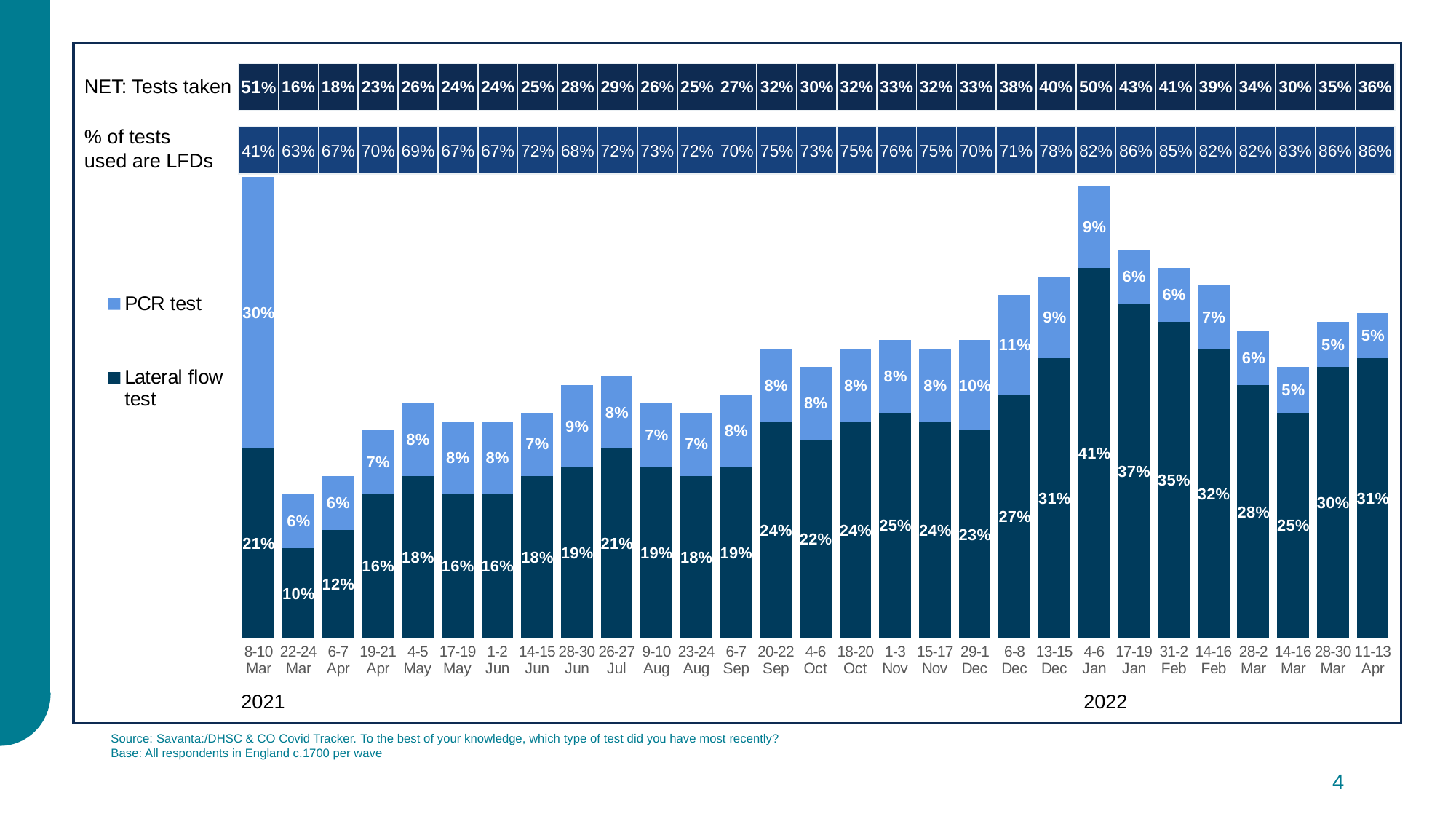
What is the NET: Tests taken value for 13-15 Dec 2021? 40% What is the total of the stacked bar for 11-13 Apr 2022? 36% Which wave has the lowest Lateral flow test value? 22-24 Mar 2021 Which wave has the highest Lateral flow test value? 4-6 Jan 2022 Which is larger, the PCR test value for 6-8 Dec 2021 or for 29-1 Dec 2021? 6-8 Dec 2021 How many date waves (bars) are plotted on the chart? 29 What kind of chart is shown on the slide? Stacked bar chart What is the difference between the Lateral flow test values for 17-19 Jan 2022 and 31-2 Feb 2022? 2% What is the PCR test value for 8-10 Mar 2021? 30% How many series does the legend list? 2 What is the Lateral flow test value for 4-6 Jan 2022? 41% What is the '% of tests used are LFDs' value for 1-3 Nov 2021? 76%